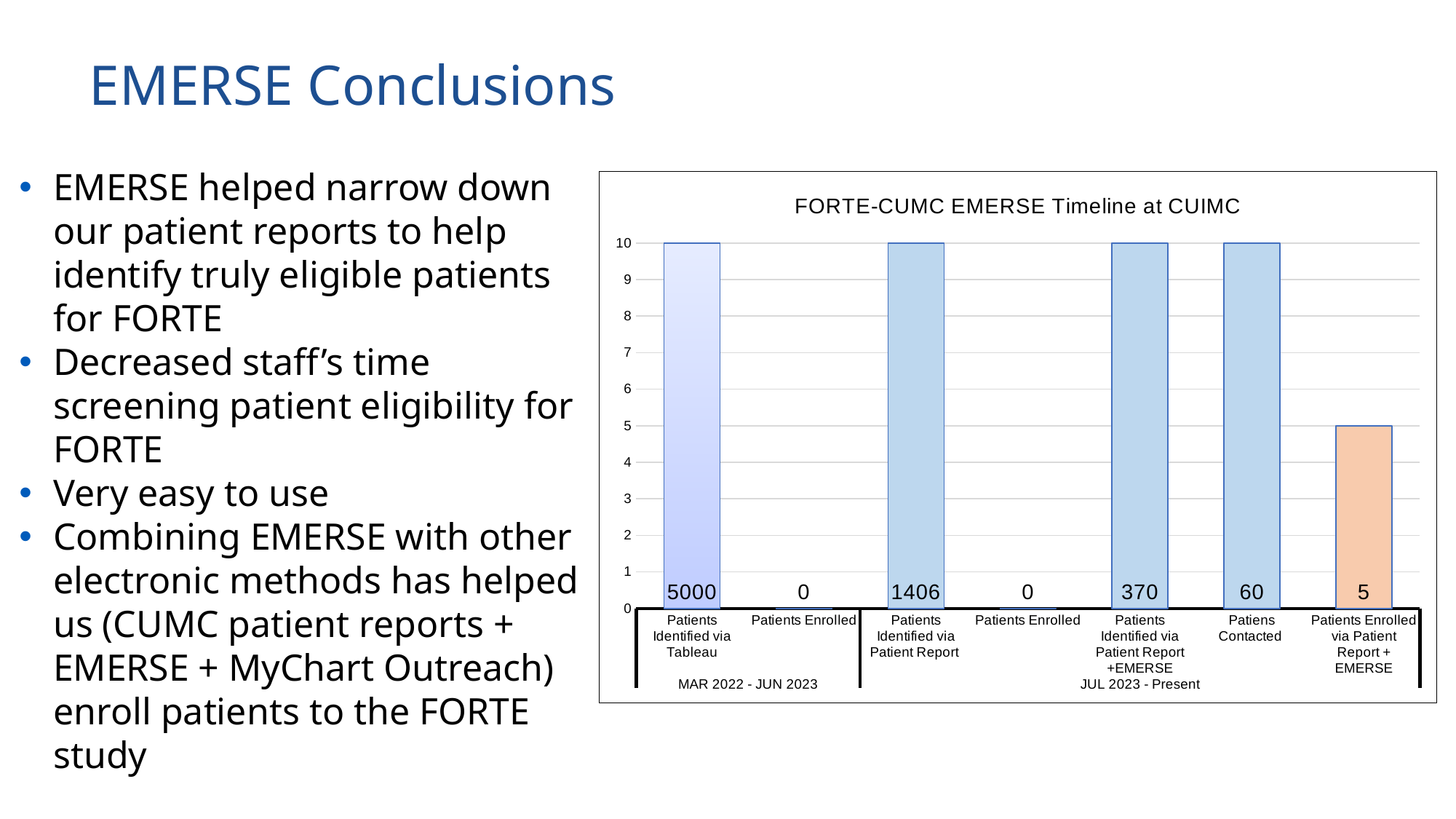
What is the difference between the labelled values for Patients Identified via Tableau and Patients Identified via Patient Report? 3594 What value is labelled for Patients Identified via Tableau? 5000 How many categories are shown along the x axis of the chart? 7 What value is labelled for Patients Identified via Patient Report? 1406 Which two time periods are labelled beneath the x axis of the chart? MAR 2022 - JUN 2023 and JUL 2023 - Present Which is larger, the labelled value for Patiens Contacted or for Patients Enrolled via Patient Report + EMERSE? Patiens Contacted Which category has the highest labelled value? Patients Identified via Tableau What is the title of the chart? FORTE-CUMC EMERSE Timeline at CUIMC What value is labelled for Patients Enrolled via Patient Report + EMERSE? 5 What value is labelled for Patients Identified via Patient Report +EMERSE? 370 What kind of chart is shown on the slide? bar chart What value is labelled for Patiens Contacted? 60